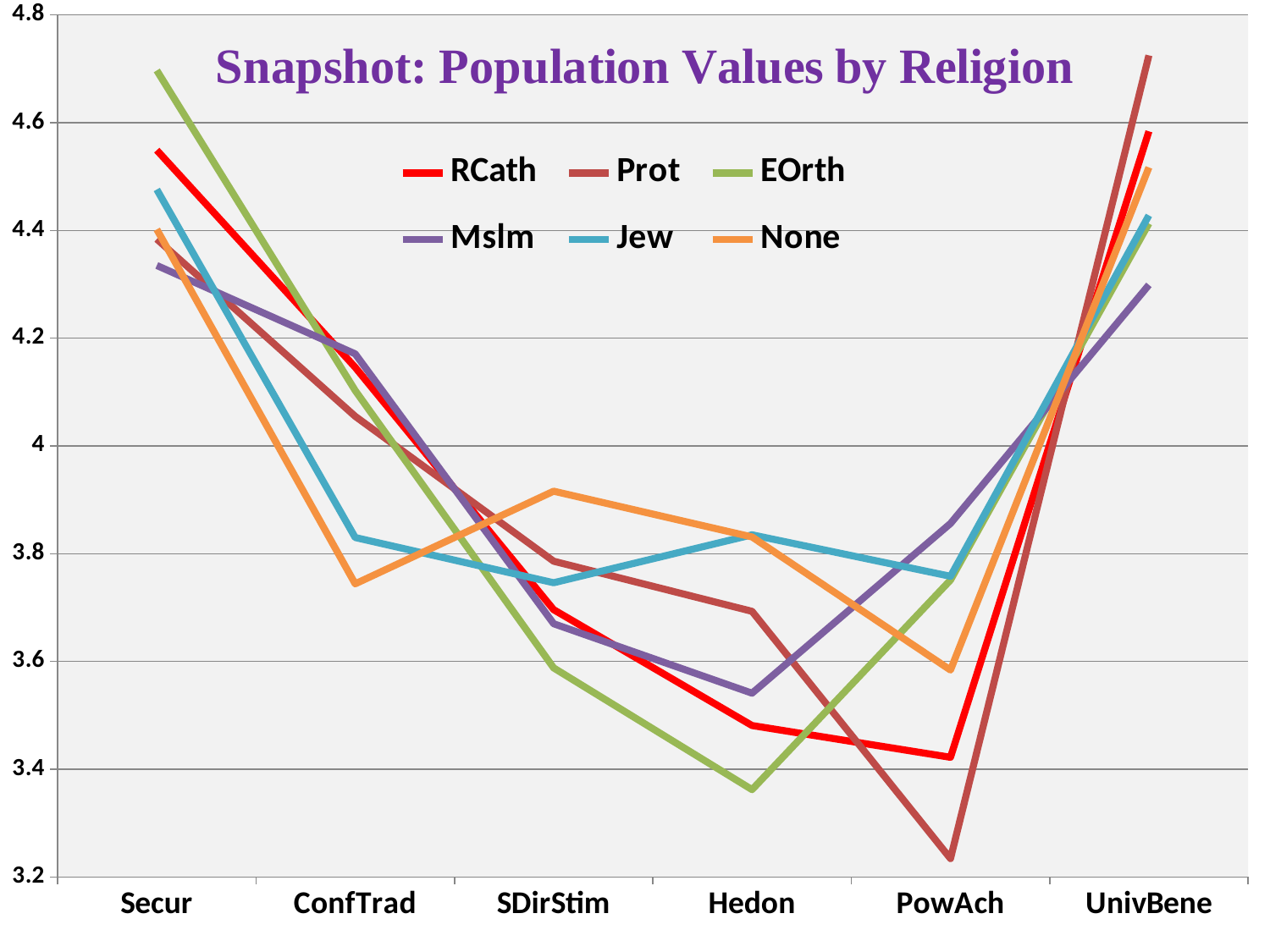
Is the value for EOrth at Secur greater or less than 4.6? greater Does the Prot line rise or fall from Secur to PowAch? fall Is the value for Prot at PowAch greater or less than 3.4? less Which series has the lowest value at PowAch? Prot How many series does the legend list? 6 Which series has the lowest value at UnivBene? Mslm Is the value for None at ConfTrad greater or less than 3.8? less What kind of chart is shown on the slide? line chart How many categories are shown along the x axis? 6 Which series has the highest value at UnivBene? Prot What is the title of the chart? Snapshot: Population Values by Religion Which series has the highest value at Secur? EOrth